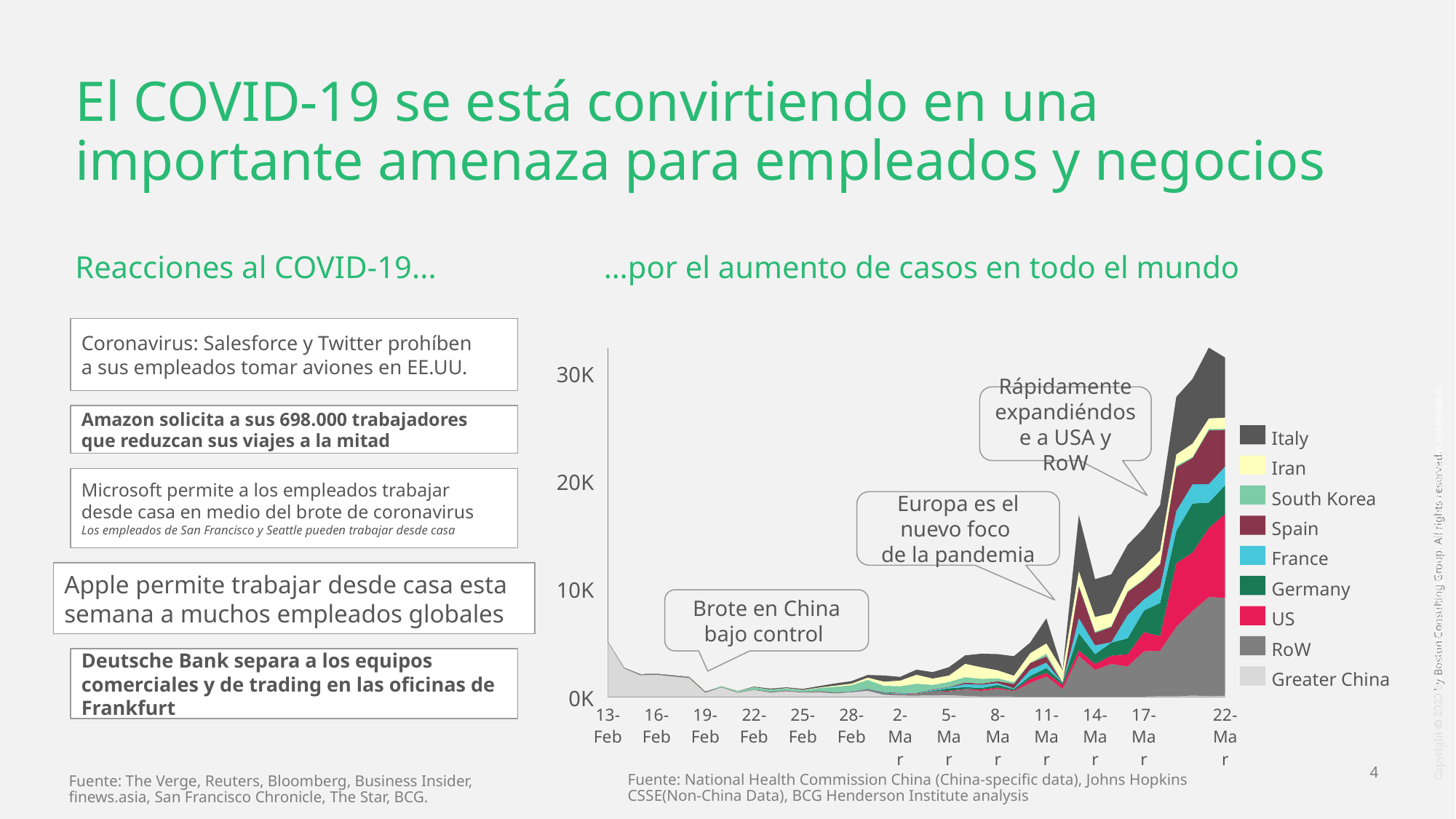
What is the first date label on the x axis of the chart? 13-Feb Is the total value on 13-Feb greater or less than 10K? less What does the annotation near the 19-Feb point of the chart say? Brote en China bajo control What is the last date label on the x axis of the chart? 22-Mar How many date labels are shown on the x axis of the chart? 13 How many series does the legend of the chart list? 9 Is the total value on 28-Feb greater or less than 10K? less Do the total values in the chart rise or fall from 13-Feb to 22-Mar? Rise Is the total value on 22-Mar greater or less than 20K? greater What kind of chart is shown on the right side of the slide? Stacked area chart Which series is listed first in the chart's legend? Italy